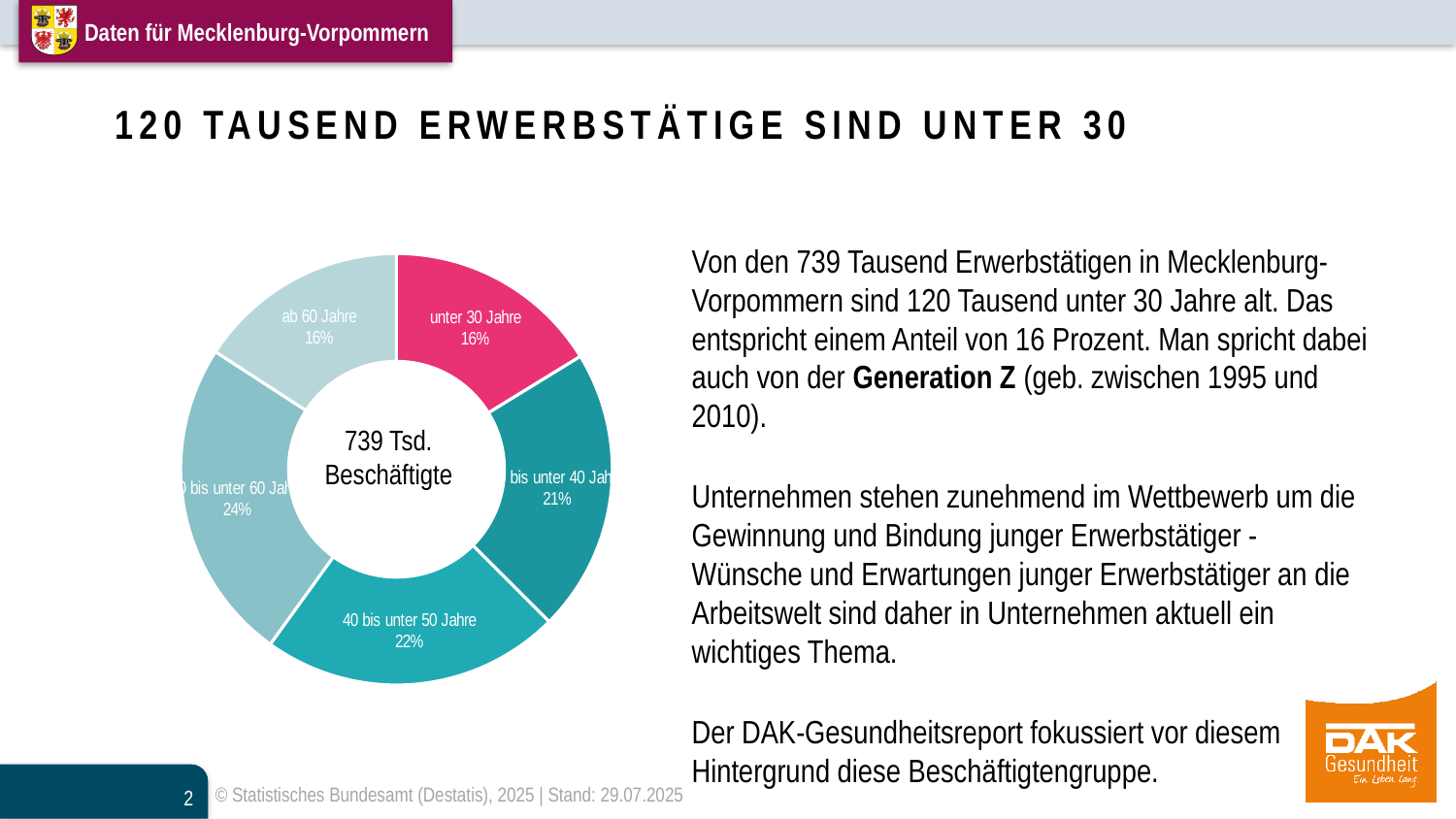
Is the share for 'unter 30 Jahre' equal to the share for 'ab 60 Jahre'? Yes, both are 16% What colour is the 'unter 30 Jahre' slice? Pink (magenta) Which two age groups share the smallest percentage in the chart? unter 30 Jahre and ab 60 Jahre Which slice is larger: '40 bis unter 50 Jahre' or 'ab 60 Jahre'? 40 bis unter 50 Jahre By how many percentage points does the '40 bis unter 50 Jahre' share exceed the 'unter 30 Jahre' share? 6 percentage points What percentage is shown for the 'ab 60 Jahre' slice? 16% What is the largest percentage shown on any slice of the donut chart? 24% What share does the '40 bis unter 50 Jahre' slice show? 22% What percentage of employees are in the 'unter 30 Jahre' group in the donut chart? 16% What type of chart is shown on the slide? Donut (pie) chart How many age-group slices does the donut chart have? 5 What text is displayed in the centre of the donut chart? 739 Tsd. Beschäftigte